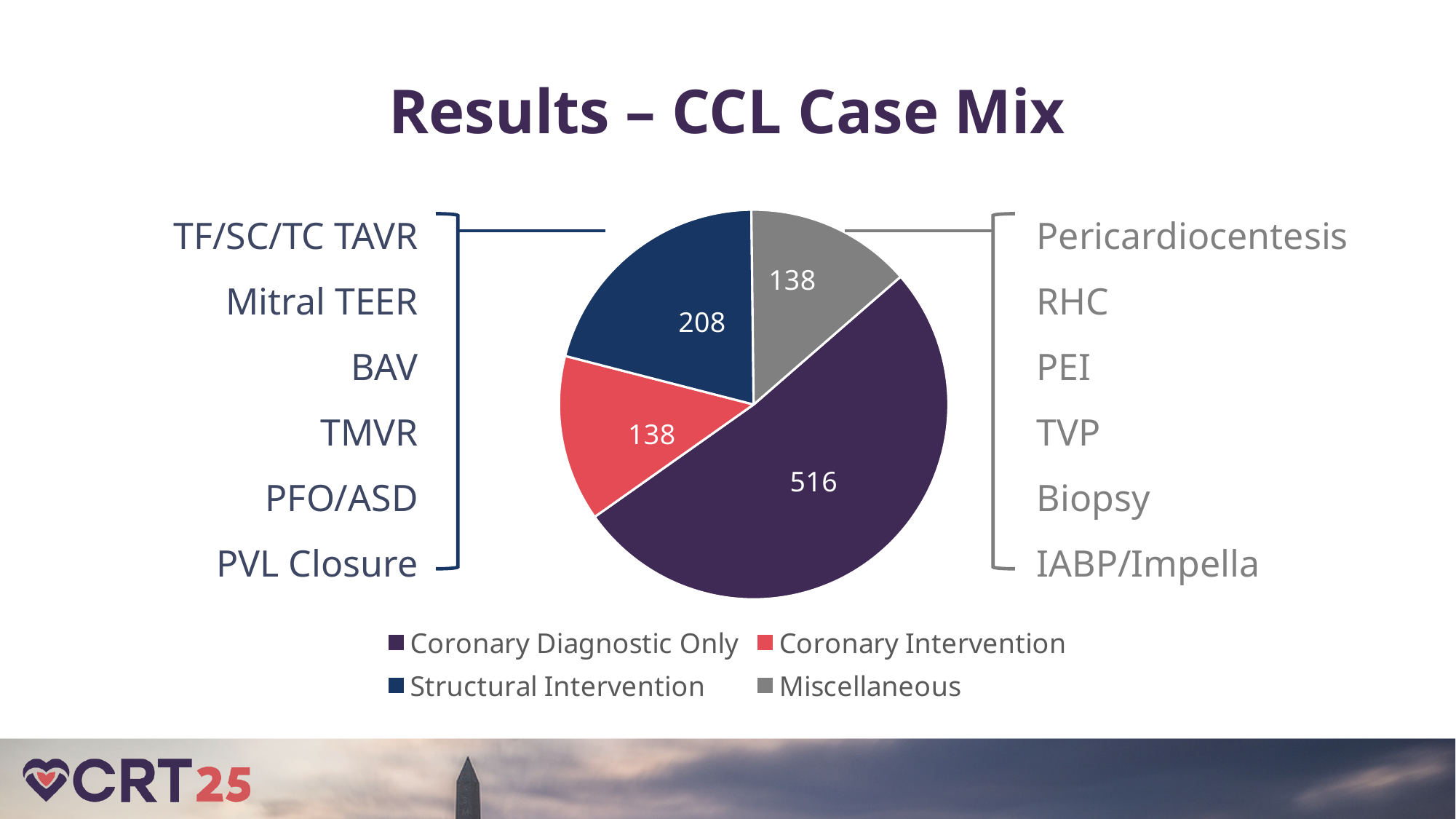
What kind of chart is shown on the slide? Pie chart What is the value for Structural Intervention? 208 What is the value for Coronary Intervention? 138 What is the total of all slices in the pie chart? 1000 What is the value for Miscellaneous? 138 What share of the pie does Coronary Diagnostic Only represent? 51.6% Which category has the largest slice of the pie? Coronary Diagnostic Only What is the difference between the Coronary Diagnostic Only and Structural Intervention values? 308 What is the value for Coronary Diagnostic Only? 516 How many categories does the pie chart have? 4 What colour is the Miscellaneous slice? Grey Which is larger, Structural Intervention or Coronary Intervention? Structural Intervention